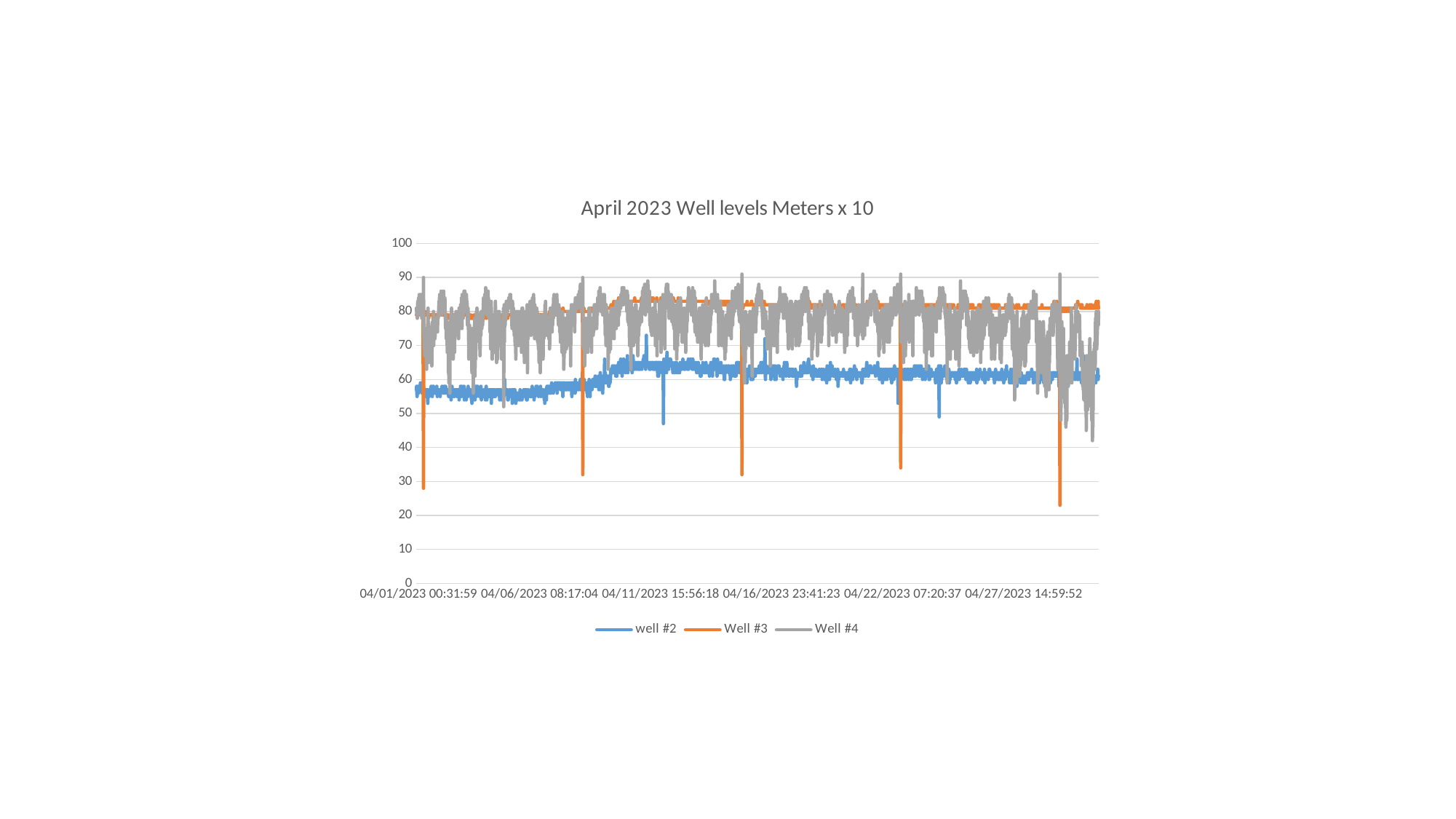
Which series generally sits higher on the chart, well #2 or Well #3? Well #3 What kind of chart is shown on the slide? line chart Is the value for well #2 at the start of the chart (04/01/2023) greater or less than 50? greater Is the lowest dip of Well #3 (near 04/27/2023) greater or less than 30? less Does the level of well #2 rise or fall from the start of April to the end of April? rise Apart from its brief dips, is the level of Well #3 greater or less than 70 throughout April? greater Which series reaches the lowest value anywhere on the chart? Well #3 Which series reaches the highest value anywhere on the chart? Well #4 What is the title of the chart? April 2023 Well levels Meters x 10 How many series does the legend list? 3 Which series is plotted in orange? Well #3